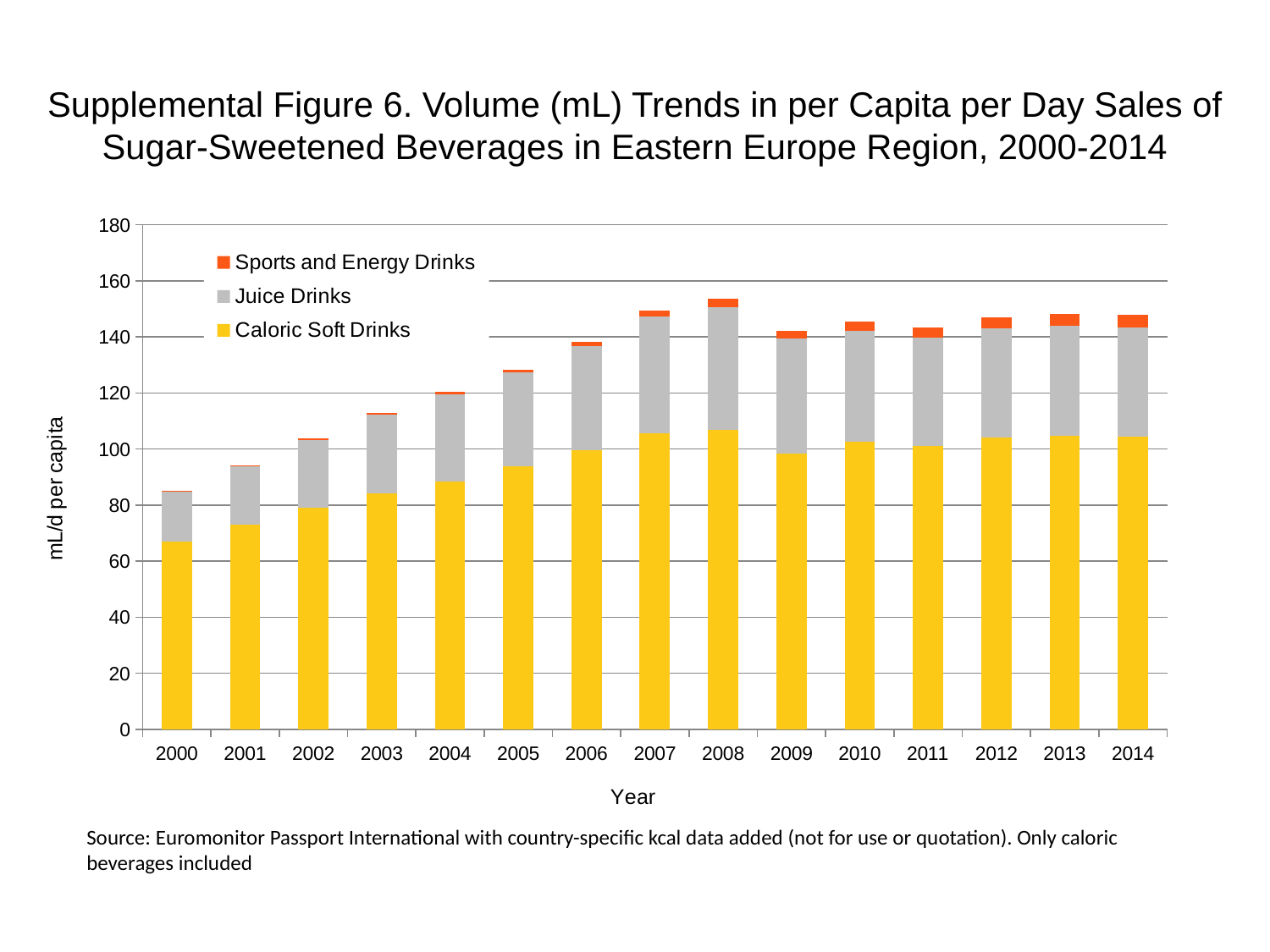
How many series does the chart's legend list? 3 Which year has the larger total stacked bar, 2008 or 2009? 2008 Which year has the highest total stacked bar? 2008 Is the Caloric Soft Drinks value for 2000 greater or less than 80? less Is the Caloric Soft Drinks value for 2008 greater or less than 100? greater Do the total stacked values rise or fall from 2000 to 2008? rise Which year has the lowest total stacked bar? 2000 Which series is shown in yellow in the chart? Caloric Soft Drinks What kind of chart is shown on the slide? Stacked bar chart Is the total stacked value for 2000 greater or less than 100? less How many years are shown along the x axis of the chart? 15 What is the label of the y axis of the chart? mL/d per capita